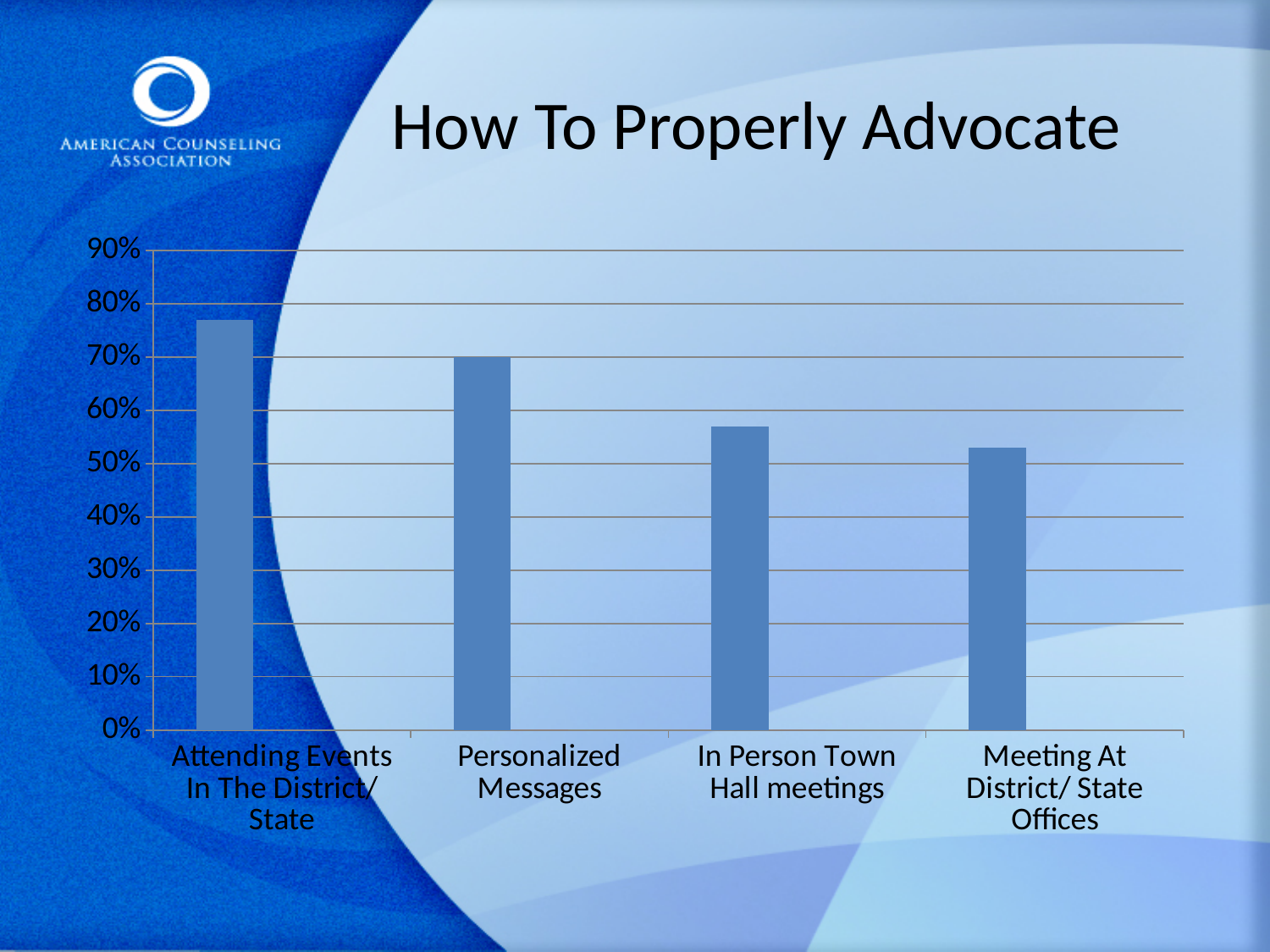
Which category has the lowest value? Meeting At District/ State Offices Is the value for Attending Events In The District/ State greater or less than 80%? less Which is larger, the value for In Person Town Hall meetings or the value for Meeting At District/ State Offices? In Person Town Hall meetings What kind of chart is shown on the slide? Bar chart What is the value for Personalized Messages? 70% Do the values rise or fall from left to right across the categories? fall How many categories are shown on the chart? 4 Is the value for Attending Events In The District/ State greater or less than 70%? greater What is the title of the slide containing the chart? How To Properly Advocate Is the value for Meeting At District/ State Offices greater or less than 50%? greater Which category has the highest value? Attending Events In The District/ State